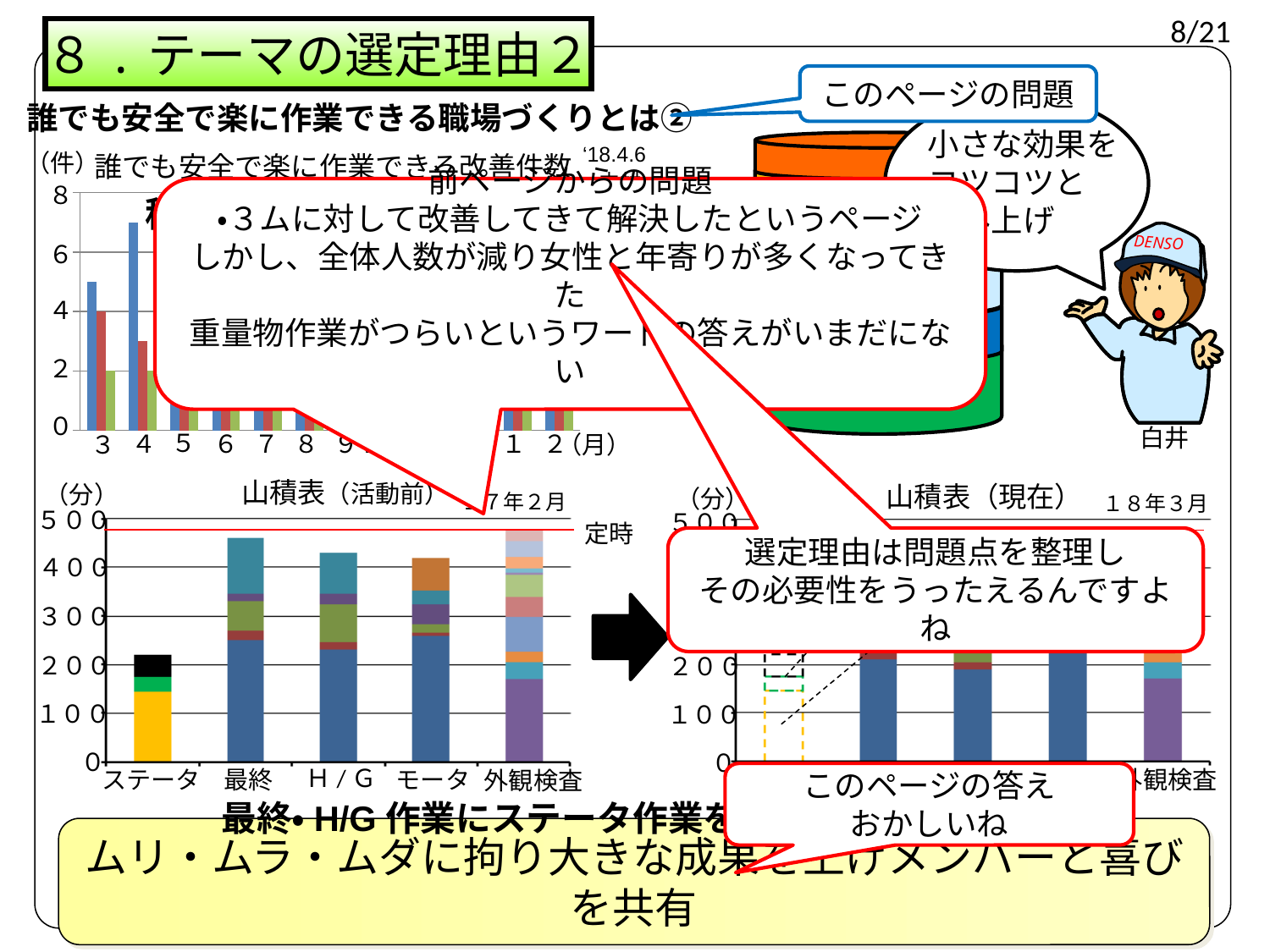
What label is given to the red horizontal line in the 山積表（活動前） chart? 定時 In the 山積表（活動前） chart, is the total for 最終 greater or less than 400? greater In the 山積表（活動前） chart, which category has the lowest total? ステータ In the top bar chart (誰でも安全で楽に作業できる改善件数), which is larger, the blue bar for month 3 or the blue bar for month 4? month 4 In the 山積表（活動前） chart, is the total for ステータ greater or less than 300? less In the top bar chart (誰でも安全で楽に作業できる改善件数), is the blue bar for month 4 greater or less than 6? greater What date label appears at the top right of the 山積表（現在） chart? １８年３月 In the 山積表（活動前） chart, which has the larger total, ステータ or H／G? H／G What is the highest value shown on the y axis of the 山積表（活動前） chart? 500 What kind of chart is the 山積表（活動前） chart at the bottom left of the slide? stacked bar chart How many categories are shown on the x axis of the 山積表（活動前） chart? 5